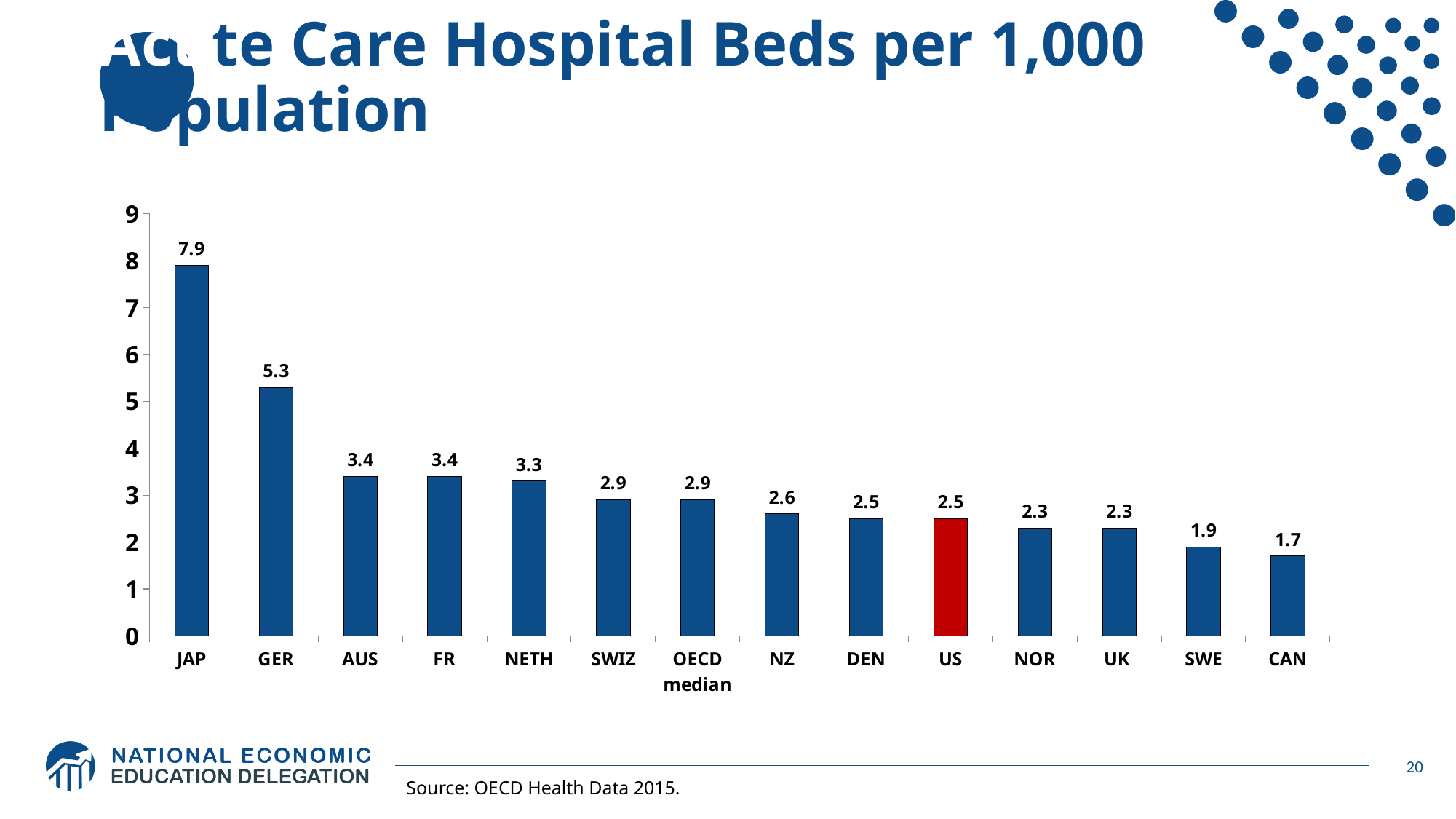
What is the value for the OECD median? 2.9 What is the value for JAP? 7.9 What kind of chart is shown on the slide? Bar chart Which bar is coloured red instead of blue? US Which country has the highest number of acute care hospital beds per 1,000 population? JAP Which has a larger value, NZ or SWE? NZ How many bars are shown in the chart? 14 What is the difference between the values for JAP and GER? 2.6 Which country has the lowest number of acute care hospital beds per 1,000 population? CAN Which has a larger value, GER or AUS? GER What is the value for the US? 2.5 What is the difference between the values for the OECD median and the US? 0.4